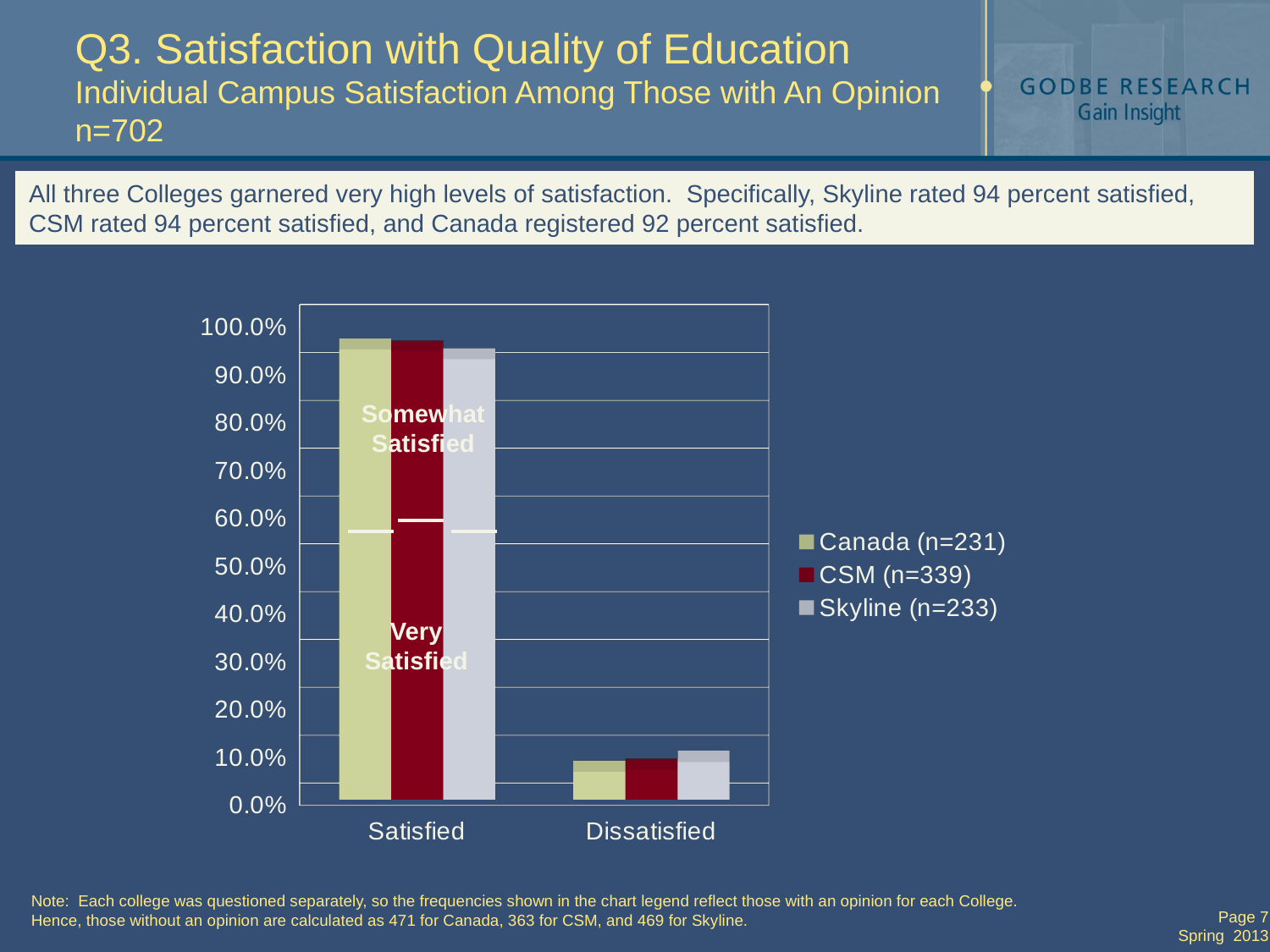
What are the two segment labels printed inside the Satisfied bars? Somewhat Satisfied and Very Satisfied Is the Dissatisfied value for Canada (n=231) greater or less than 10.0%? less Is the Satisfied value for Canada (n=231) greater or less than 90.0%? greater How many series does the chart legend list? 3 What sample size is shown in the legend for CSM? n=339 Is the Satisfied value for CSM (n=339) greater or less than 80.0%? greater What kind of chart is shown on the slide? Bar chart In the Dissatisfied category, is the bar for Skyline (n=233) taller or shorter than the bar for Canada (n=231)? Taller Which category, Satisfied or Dissatisfied, has the taller bars? Satisfied How many categories are shown on the x axis of the chart? 2 Which series has the tallest bar in the Dissatisfied category? Skyline (n=233)